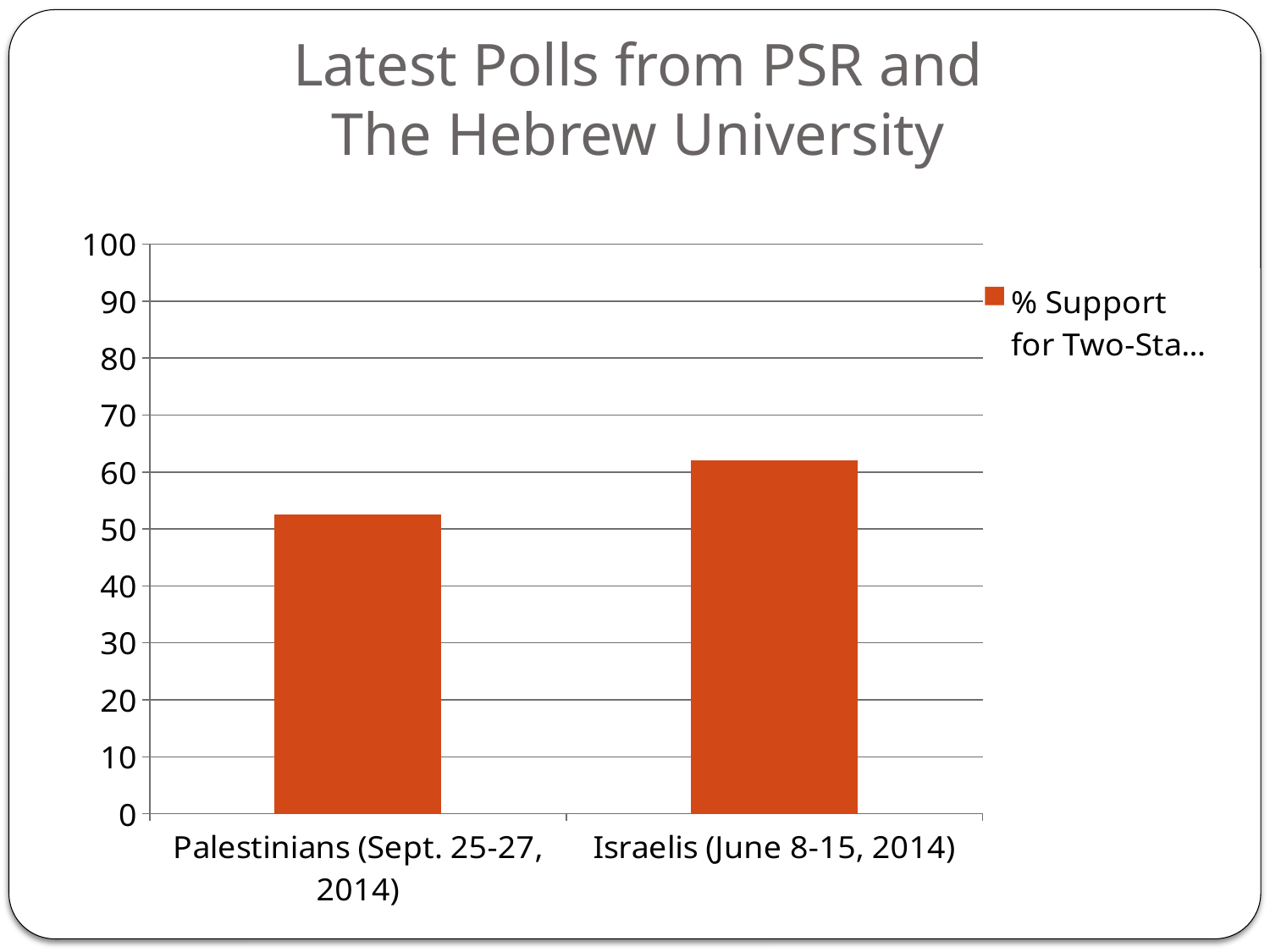
What kind of chart is shown on the slide? bar chart What is the title of the chart on the slide? Latest Polls from PSR and The Hebrew University How many categories are plotted on the chart? 2 Which category has the highest value on the chart? Israelis (June 8-15, 2014) Is the value for Palestinians (Sept. 25-27, 2014) greater or less than 60? less Is the value for Palestinians (Sept. 25-27, 2014) greater or less than 40? greater Do the values rise or fall from left to right across the categories? rise Is the value for Israelis (June 8-15, 2014) greater or less than 50? greater Which category has the higher value, Palestinians (Sept. 25-27, 2014) or Israelis (June 8-15, 2014)? Israelis (June 8-15, 2014) How many series does the legend list? 1 Which category has the lowest value on the chart? Palestinians (Sept. 25-27, 2014)